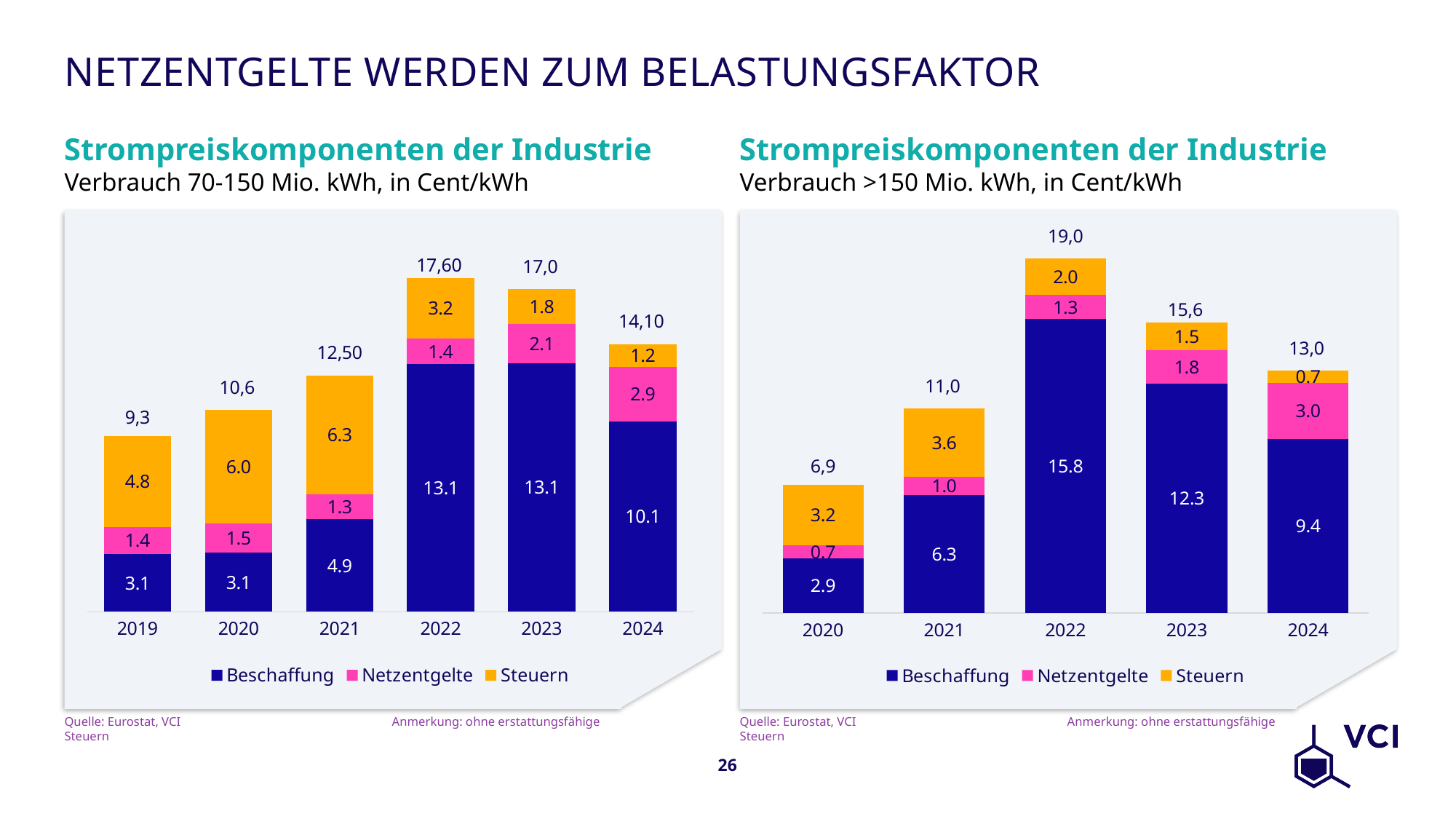
In the left chart (Verbrauch 70-150 Mio. kWh), what is the difference between the Netzentgelte values for 2024 and 2019? 1.5 In the right chart (Verbrauch >150 Mio. kWh), is the Beschaffung value for 2022 larger or smaller than the Beschaffung value for 2023? larger In the right chart (Verbrauch >150 Mio. kWh), which year has the highest total? 2022 How many years are shown on the x axis of the right chart (Verbrauch >150 Mio. kWh)? 5 How many series does the legend of the left chart (Verbrauch 70-150 Mio. kWh) list? 3 What kind of chart is the left chart (Verbrauch 70-150 Mio. kWh)? stacked bar chart In the left chart (Verbrauch 70-150 Mio. kWh), what is the total of the stacked bar for 2022? 17,60 In the left chart (Verbrauch 70-150 Mio. kWh), what is the Steuern value for 2021? 6.3 In the left chart (Verbrauch 70-150 Mio. kWh), what is the Beschaffung value for 2022? 13.1 In the right chart (Verbrauch >150 Mio. kWh), what is the Netzentgelte value for 2024? 3.0 In the left chart (Verbrauch 70-150 Mio. kWh), which year has the lowest total? 2019 In the right chart (Verbrauch >150 Mio. kWh), what is the total of the stacked bar for 2020? 6,9